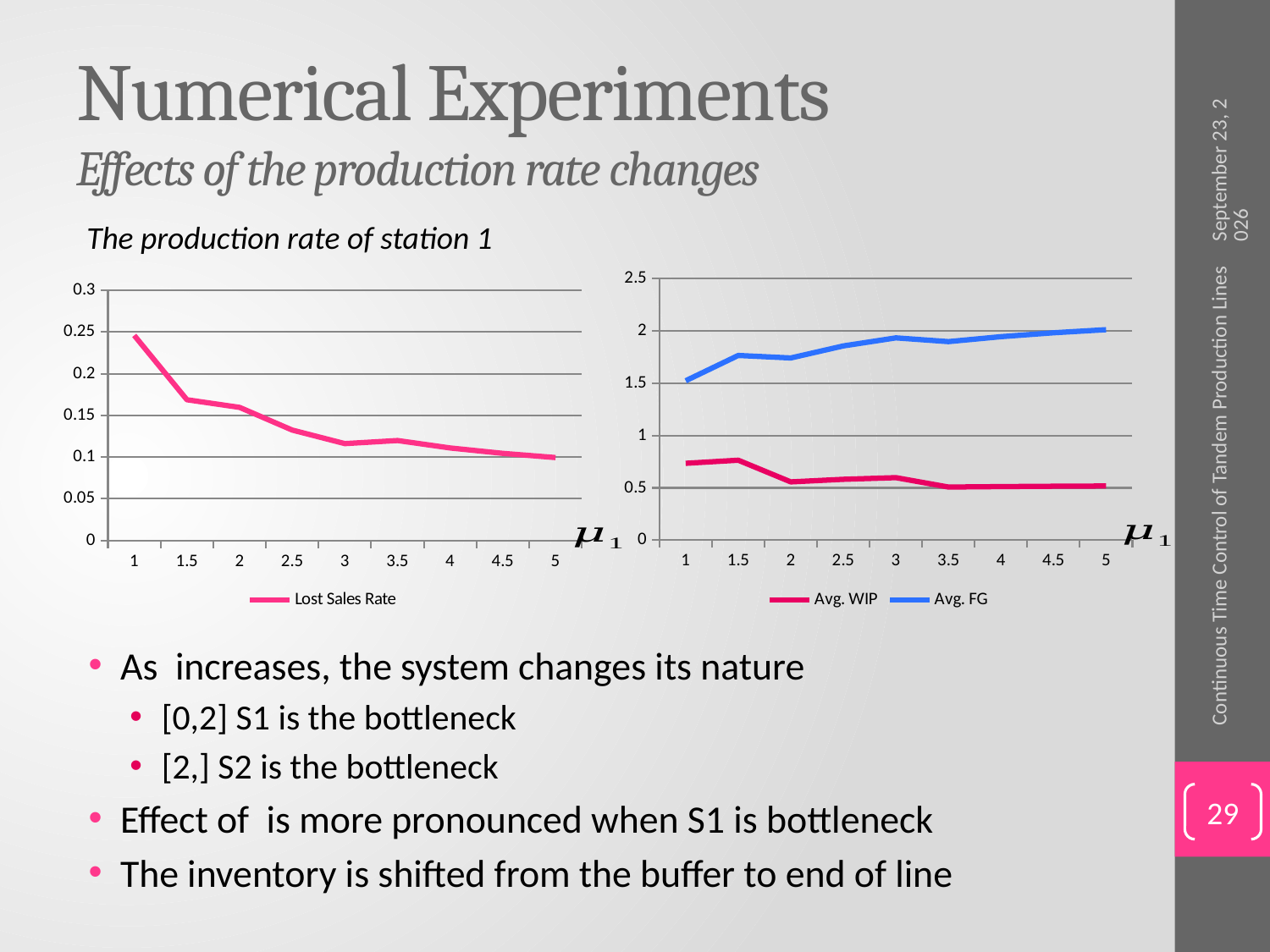
On the right chart, is the Avg. FG value at x = 5 greater or less than 1.5? greater What are the two series named in the legend of the right chart? Avg. WIP and Avg. FG On the left chart, is the Lost Sales Rate at x = 5 greater or less than 0.15? less On the left chart, does the Lost Sales Rate rise or fall as the x-axis value increases from 1 to 5? fall How many x-axis points are plotted on the left chart (Lost Sales Rate)? 9 On the right chart, does Avg. FG rise or fall as the x-axis value increases from 1 to 5? rise On the right chart, which series is larger at x = 3, Avg. WIP or Avg. FG? Avg. FG On the left chart, at which x-axis value is the Lost Sales Rate highest? 1 On the left chart, is the Lost Sales Rate at x = 1 greater or less than 0.2? greater What kind of chart is the left chart (Lost Sales Rate)? line chart How many series does the legend of the right chart list? 2